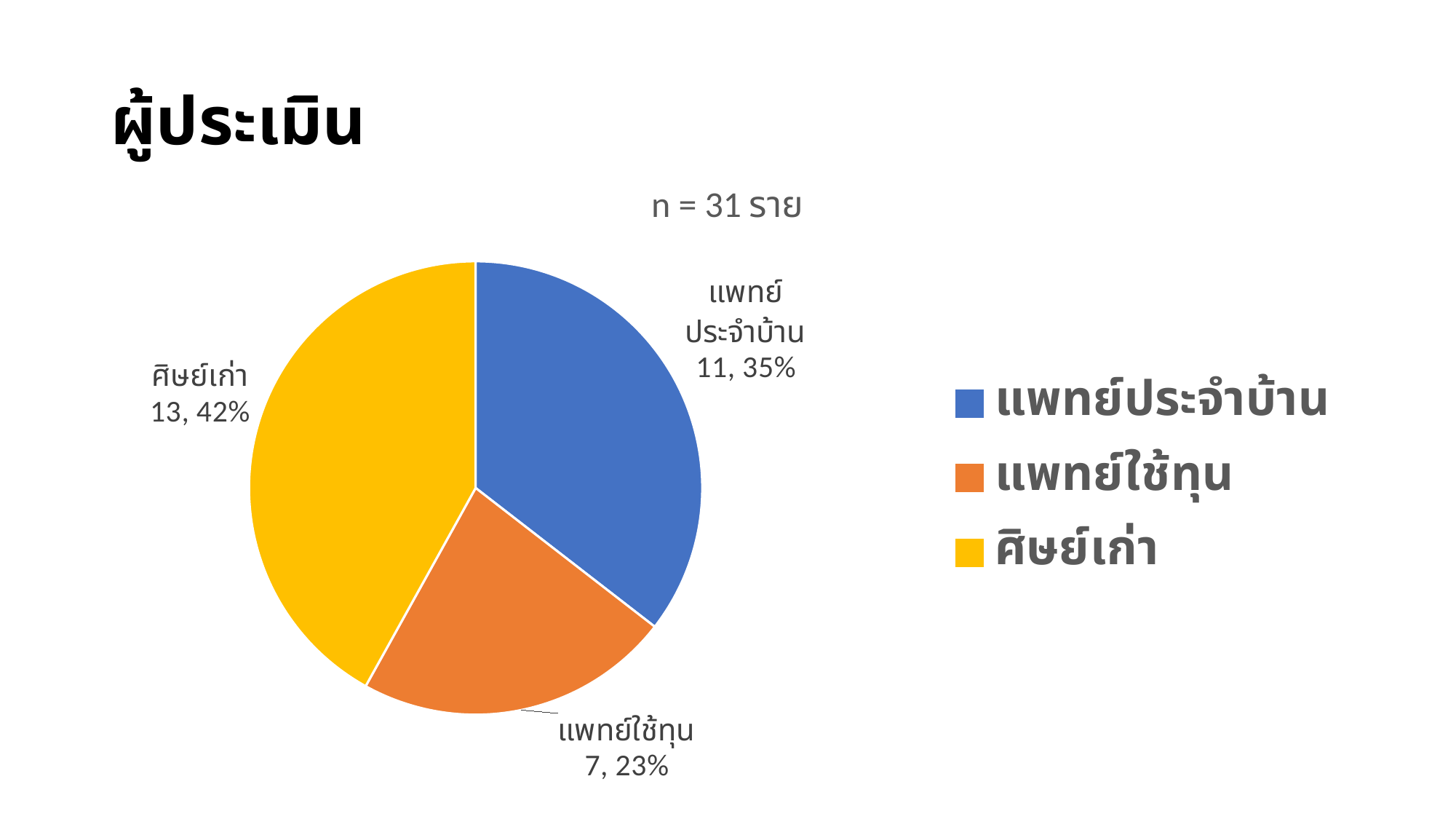
What share of the pie does ศิษย์เก่า represent? 42% Which category has the smallest slice? แพทย์ใช้ทุน What is the count for แพทย์ใช้ทุน? 7 Which category has the largest slice? ศิษย์เก่า What is the count for แพทย์ประจำบ้าน? 11 What is the count for ศิษย์เก่า? 13 Which is larger, แพทย์ประจำบ้าน or แพทย์ใช้ทุน? แพทย์ประจำบ้าน What is the difference between the counts for ศิษย์เก่า and แพทย์ใช้ทุน? 6 What is the total n shown above the pie chart? n = 31 ราย How many slices does the pie chart have? 3 What kind of chart is shown on the slide? pie chart What share of the pie does แพทย์ใช้ทุน represent? 23%